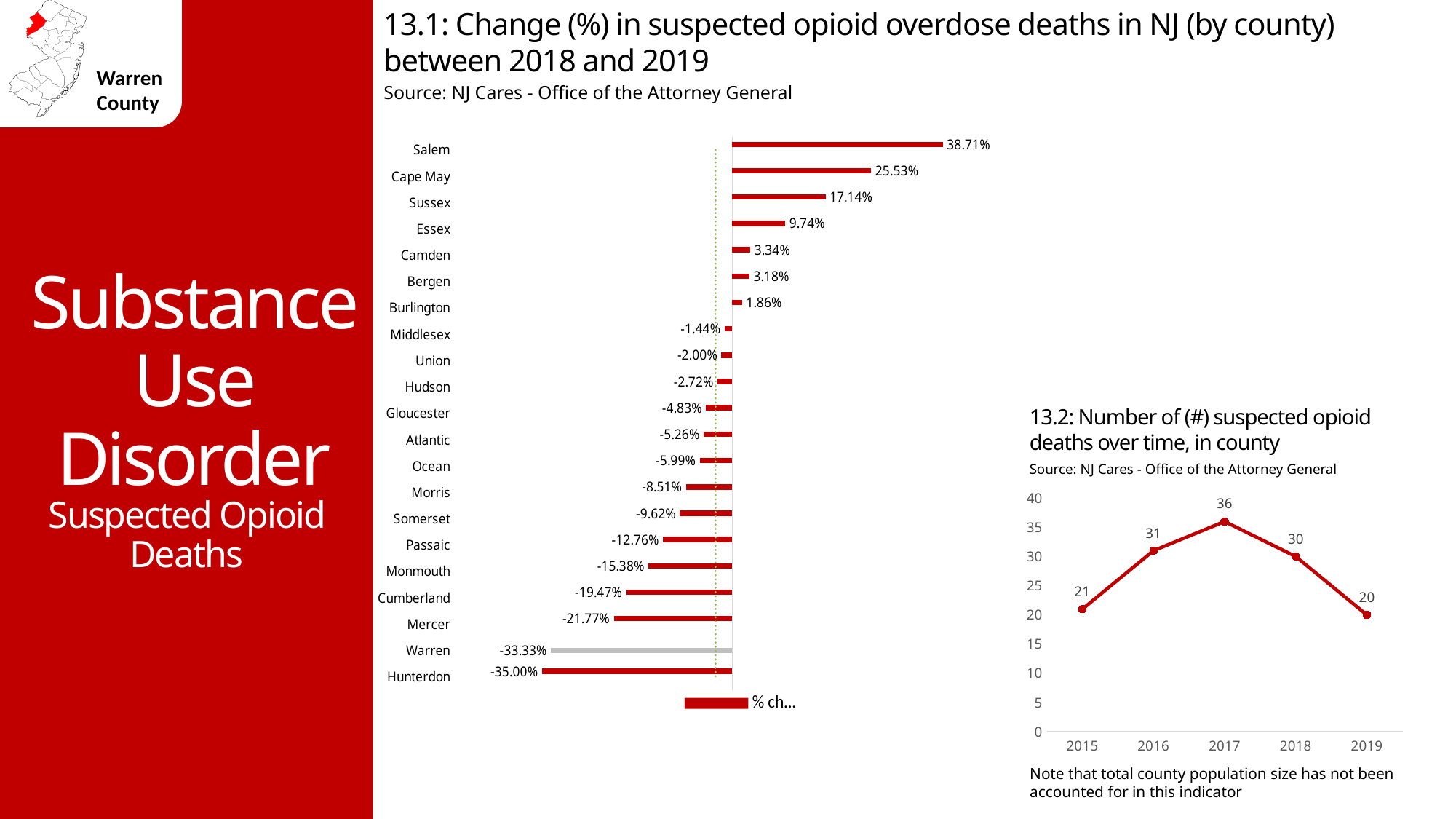
In chart 13.1, which has a larger change (%), Sussex or Essex? Sussex In chart 13.1, what is the change (%) in suspected opioid overdose deaths for Warren County? -33.33% In chart 13.1, which county has the lowest change (%) in suspected opioid overdose deaths? Hunterdon In chart 13.1, how many counties are shown? 21 In chart 13.2, what is the difference in suspected opioid deaths between 2017 and 2019? 16 What kind of chart is chart 13.2? Line chart In chart 13.1, what is the change (%) for Cape May? 25.53% What kind of chart is chart 13.1? Bar chart In chart 13.2, how many years are plotted? 5 In chart 13.1, which county has the highest change (%) in suspected opioid overdose deaths? Salem In chart 13.2, how many suspected opioid deaths were there in 2017? 36 In chart 13.2, which year has the lowest number of suspected opioid deaths? 2019